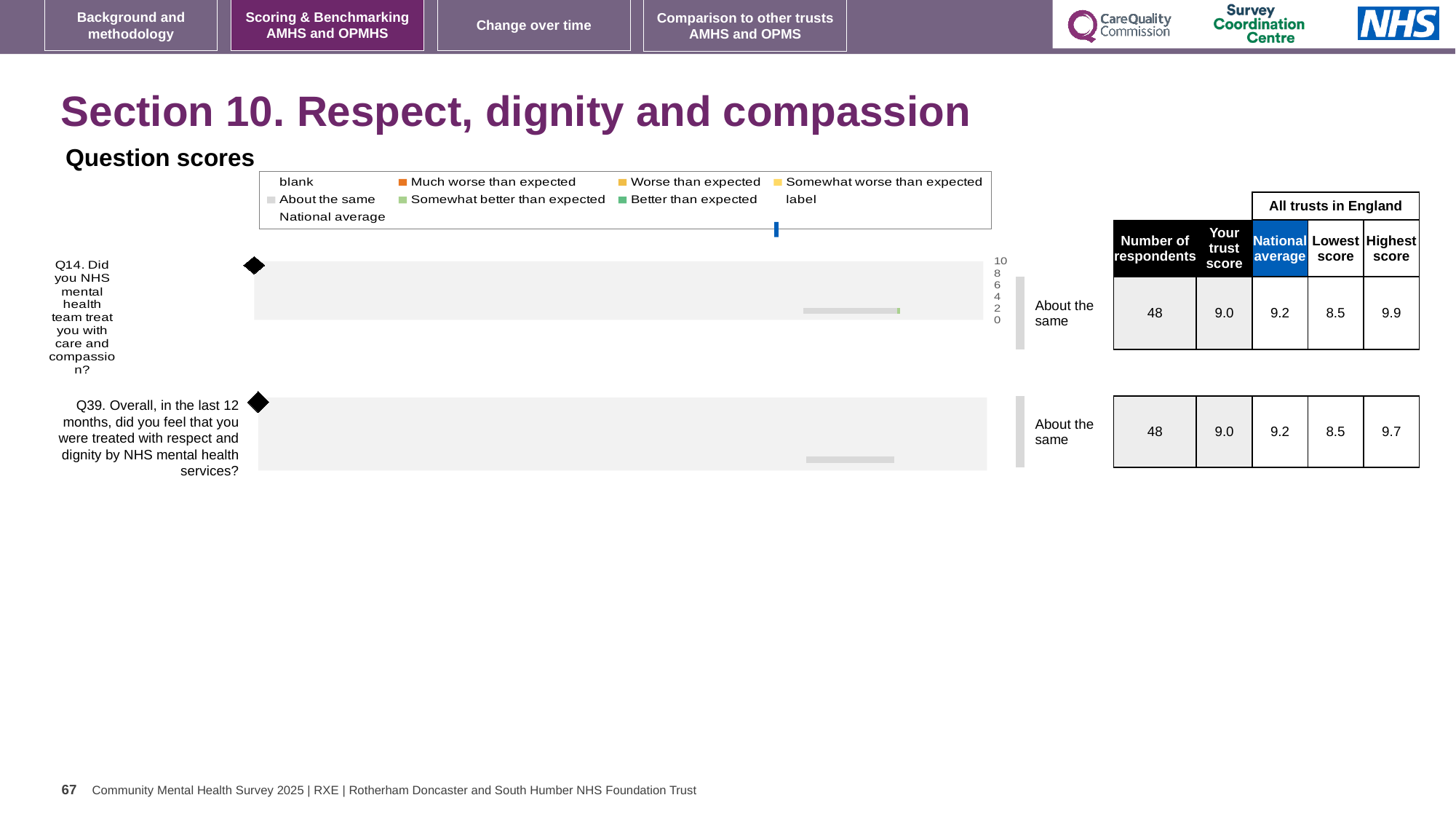
What benchmark category is shown for Q14 next to its chart? About the same What is the highest score among all trusts in England for Q14? 9.9 What is the national average for Q39 (respect and dignity) shown in the table? 9.2 How many respondents answered Q39? 48 What kind of chart is used to show the question scores for Q14 and Q39? bar chart How many questions are plotted in the Question scores charts on this slide? 2 What is the title of the chart area on this slide? Question scores What is the difference between the national average and the trust's score for Q39? 0.2 What is the difference between the highest score and the lowest score for Q14? 1.4 What is the highest score among all trusts in England for Q39? 9.7 What is the trust's score for Q14 (care and compassion) shown in the table next to the chart? 9.0 Which question has the higher highest score across all trusts in England, Q14 or Q39? Q14